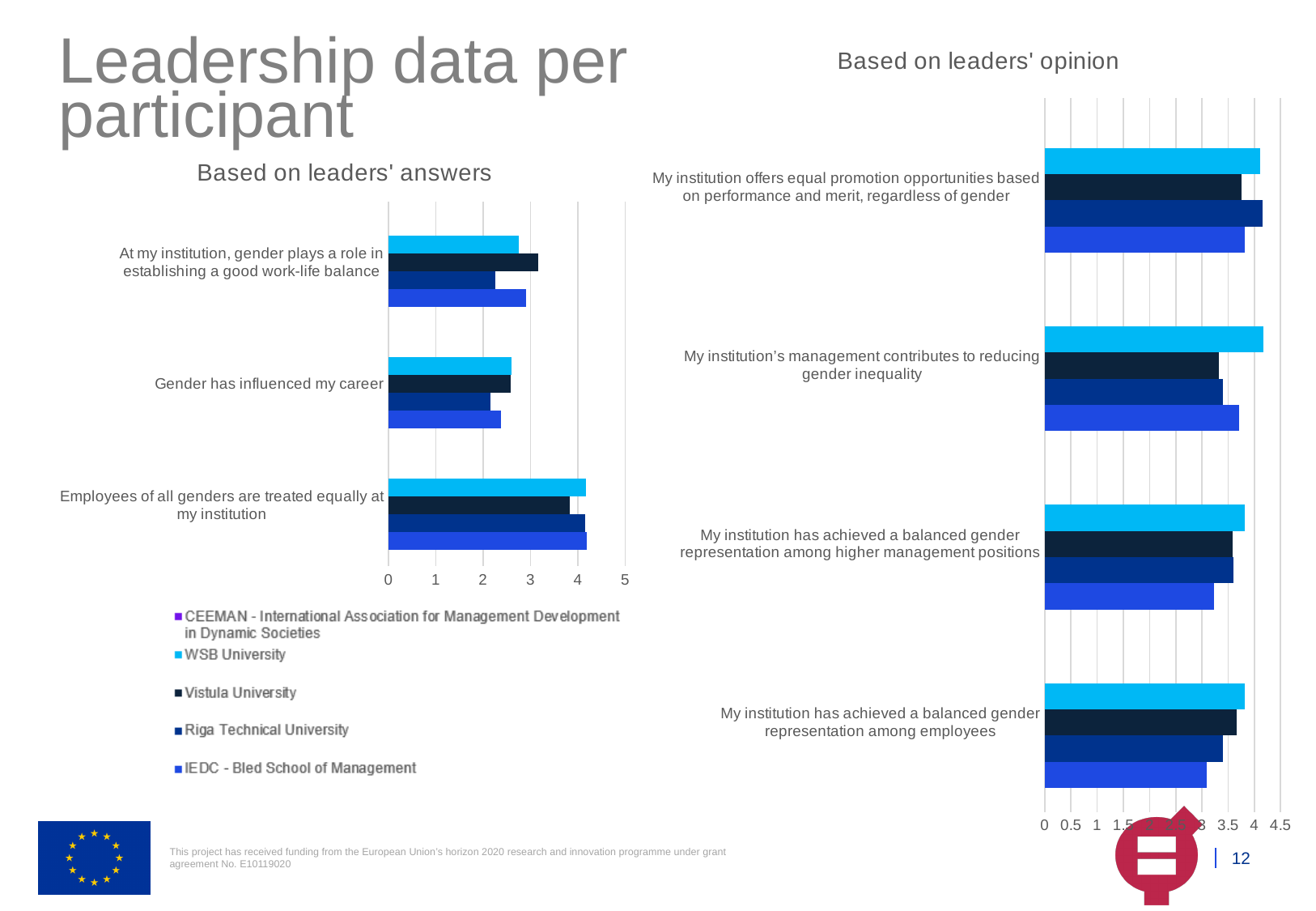
How many categories (statements) does the 'Based on leaders' opinion' chart show? 4 What kind of chart is the 'Based on leaders' answers' chart? bar chart In the 'Based on leaders' answers' chart, is the Vistula University value for 'At my institution, gender plays a role in establishing a good work-life balance' greater or less than 3? greater What is the title of the chart on the right side of the slide? Based on leaders' opinion In the 'Based on leaders' answers' chart, is the WSB University value for 'Employees of all genders are treated equally at my institution' greater or less than 4? greater In the 'Based on leaders' answers' chart, for which statement is the WSB University value highest? Employees of all genders are treated equally at my institution In the 'Based on leaders' answers' chart, which is larger for 'Employees of all genders are treated equally at my institution': WSB University or Vistula University? WSB University In the 'Based on leaders' opinion' chart, is the IEDC - Bled School of Management value for 'My institution has achieved a balanced gender representation among employees' greater or less than 3.5? less In the 'Based on leaders' opinion' chart, which is larger for 'My institution's management contributes to reducing gender inequality': WSB University or Vistula University? WSB University How many series does the legend on the slide list? 5 How many categories (statements) does the 'Based on leaders' answers' chart show? 3